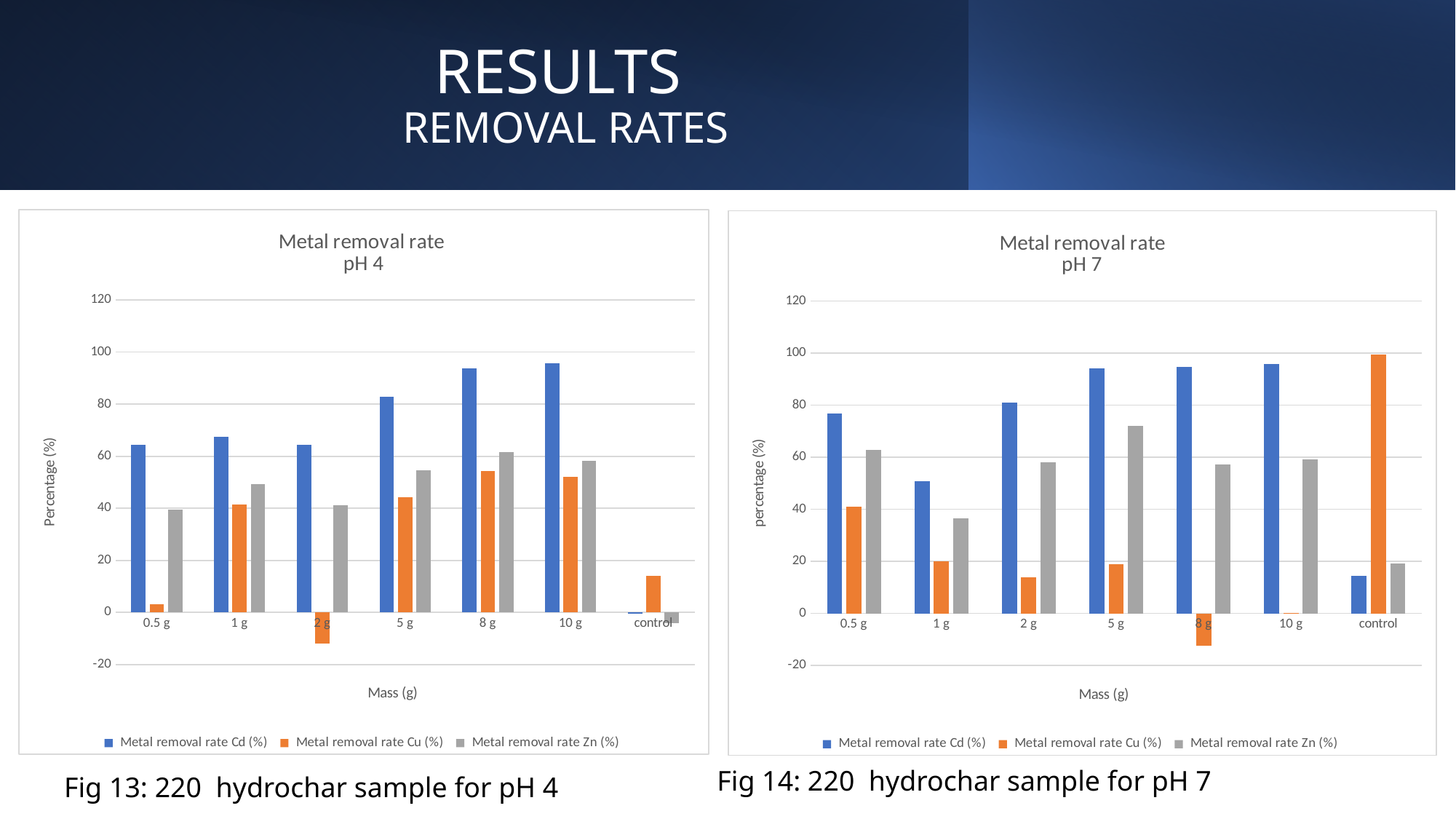
In the 'Metal removal rate pH 7' chart, which category has the highest Cu removal rate? control In the 'Metal removal rate pH 7' chart, at 0.5 g, which is larger: the Cd removal rate or the Zn removal rate? Cd In the 'Metal removal rate pH 7' chart, how many series does the legend list? 3 What is the x-axis title of the 'Metal removal rate pH 7' chart? Mass (g) In the 'Metal removal rate pH 4' chart, how many categories are shown on the x axis? 7 In the 'Metal removal rate pH 4' chart, does the Cd removal rate rise or fall from 2 g to 10 g? rise In the 'Metal removal rate pH 7' chart, is the Zn removal rate at 5 g greater or less than 60? greater In the 'Metal removal rate pH 4' chart, is the Cu removal rate at 2 g greater or less than 0? less In the 'Metal removal rate pH 7' chart, at 1 g, which is larger: the Cu removal rate or the Zn removal rate? Zn What type of chart is the 'Metal removal rate pH 4' chart? bar chart In the 'Metal removal rate pH 4' chart, which category has the lowest Cu removal rate? 2 g In the 'Metal removal rate pH 4' chart, is the Cd removal rate at 8 g greater or less than 80? greater